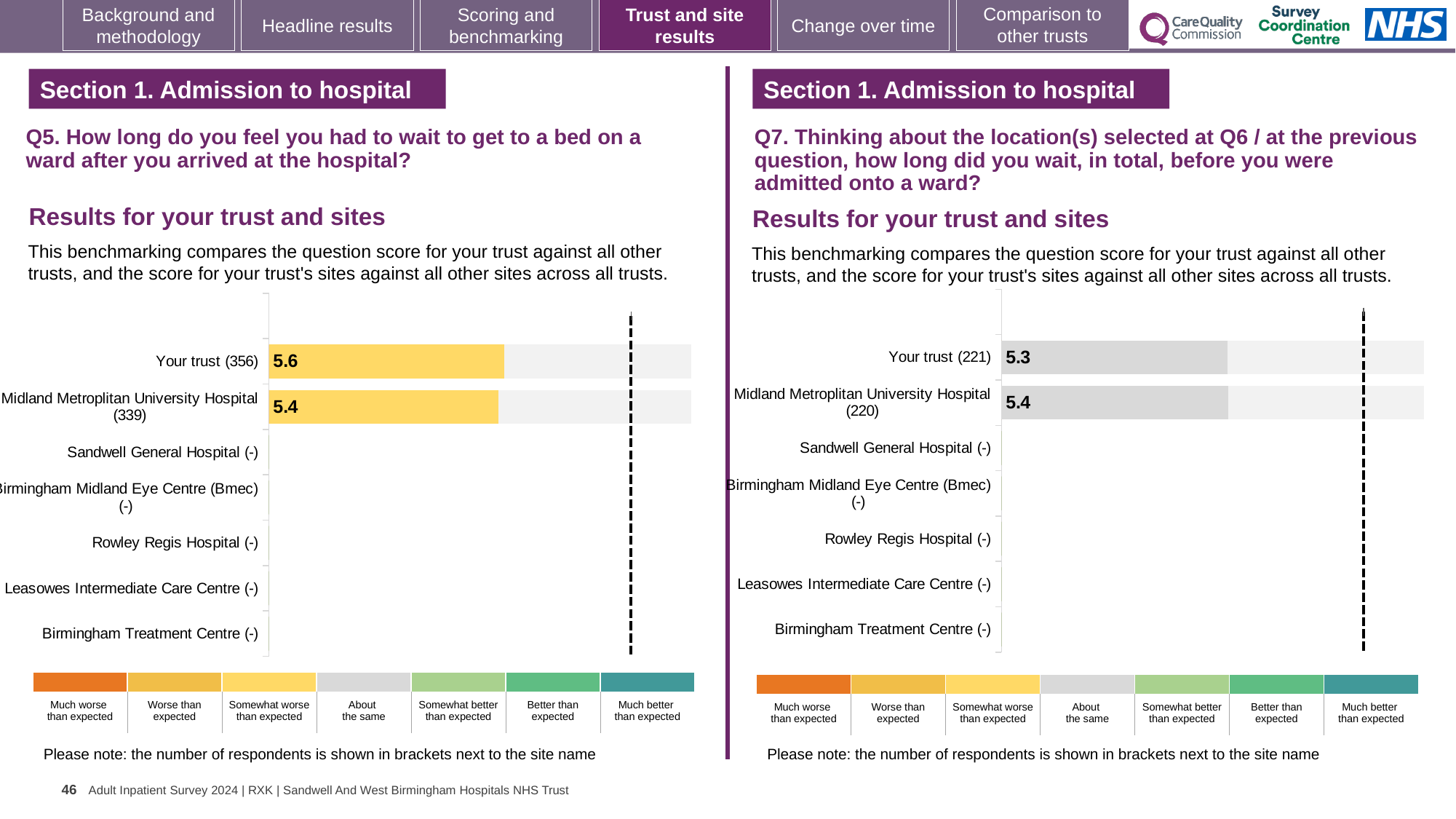
On the Q5 chart (left), what is the score for Midland Metropolitan University Hospital (339)? 5.4 What type of chart is used on the Q5 chart (left)? Bar chart On the Q7 chart (right), how many categories have a plotted bar with a score? 2 On the Q7 chart (right), what is the difference between the score for Midland Metropolitan University Hospital and the score for Your trust? 0.1 On the Q7 chart (right), what is the score for Your trust (221)? 5.3 On the Q5 chart (left), how many site or trust categories are listed on the vertical axis? 7 On the Q5 chart (left), which has the higher score: Your trust or Midland Metropolitan University Hospital? Your trust On the Q5 chart (left), what is the difference between the score for Your trust and the score for Midland Metropolitan University Hospital? 0.2 On the Q5 chart (left), what is the score for Your trust (356)? 5.6 On the Q7 chart (right), which benchmark category does the colour of the bars correspond to according to the legend? About the same On the Q7 chart (right), which has the higher score: Your trust or Midland Metropolitan University Hospital? Midland Metropolitan University Hospital On the Q7 chart (right), what is the score for Midland Metropolitan University Hospital (220)? 5.4